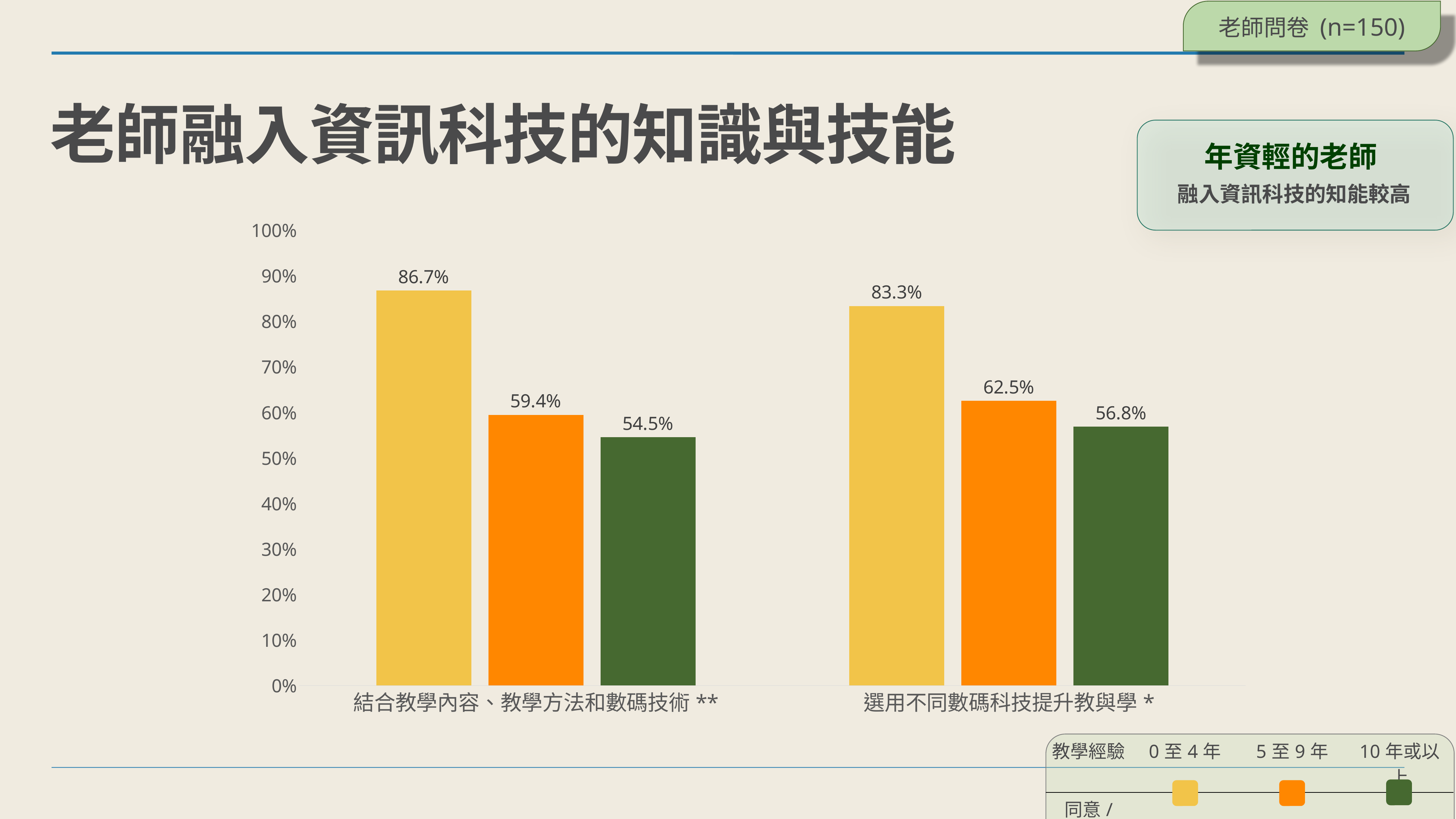
What is the value for teachers with 0 至 4 年 teaching experience in the category 結合教學內容、教學方法和數碼技術? 86.7% What is the difference between the 5 至 9 年 and 10 年或以上 values in the category 選用不同數碼科技提升教與學? 5.7% What is the difference between the 0 至 4 年 and 10 年或以上 values in the category 結合教學內容、教學方法和數碼技術? 32.2% What is the value for teachers with 10 年或以上 teaching experience in the category 結合教學內容、教學方法和數碼技術? 54.5% Which teaching-experience group has the lowest value in the category 結合教學內容、教學方法和數碼技術? 10 年或以上 What is the value for teachers with 5 至 9 年 teaching experience in the category 選用不同數碼科技提升教與學? 62.5% How many categories are shown on the x axis? 2 What is the value for teachers with 0 至 4 年 teaching experience in the category 選用不同數碼科技提升教與學? 83.3% What kind of chart is shown on the slide? Bar chart How many series does the legend list? 3 Which teaching-experience group has the highest value in the category 選用不同數碼科技提升教與學? 0 至 4 年 Which is larger: the 0 至 4 年 value for 結合教學內容、教學方法和數碼技術 or the 0 至 4 年 value for 選用不同數碼科技提升教與學? 結合教學內容、教學方法和數碼技術